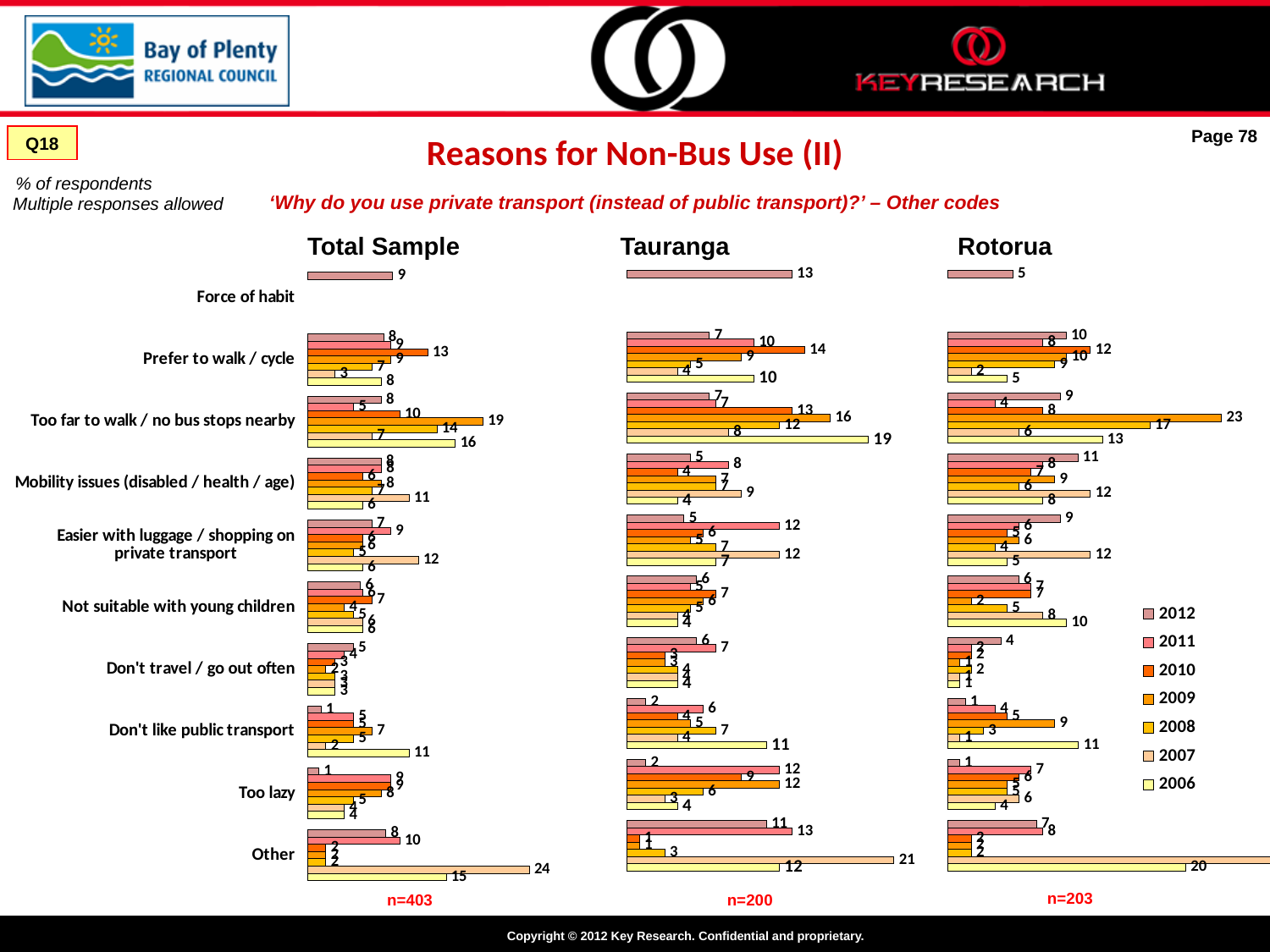
What kind of chart is used for the Tauranga data? Bar chart On the Rotorua chart, what is the 2009 value for Too far to walk / no bus stops nearby? 23 On the Total Sample chart, what is the 2007 value for Other? 24 On the Tauranga chart, what is the value for Force of habit in 2012? 13 On the Total Sample chart, what is the value for Force of habit in 2012? 9 On the Total Sample chart, which year has the highest value for Too far to walk / no bus stops nearby? 2009 For Force of habit in 2012, which is larger: the Tauranga value or the Rotorua value? Tauranga On the Tauranga chart, what is the 2007 value for Other? 21 How many series does the legend list? 7 How many reason categories are shown on the Total Sample chart? 10 On the Total Sample chart, what is the difference between the 2009 and 2006 values for Too far to walk / no bus stops nearby? 3 On the Rotorua chart, which year has the highest value for Too far to walk / no bus stops nearby? 2009